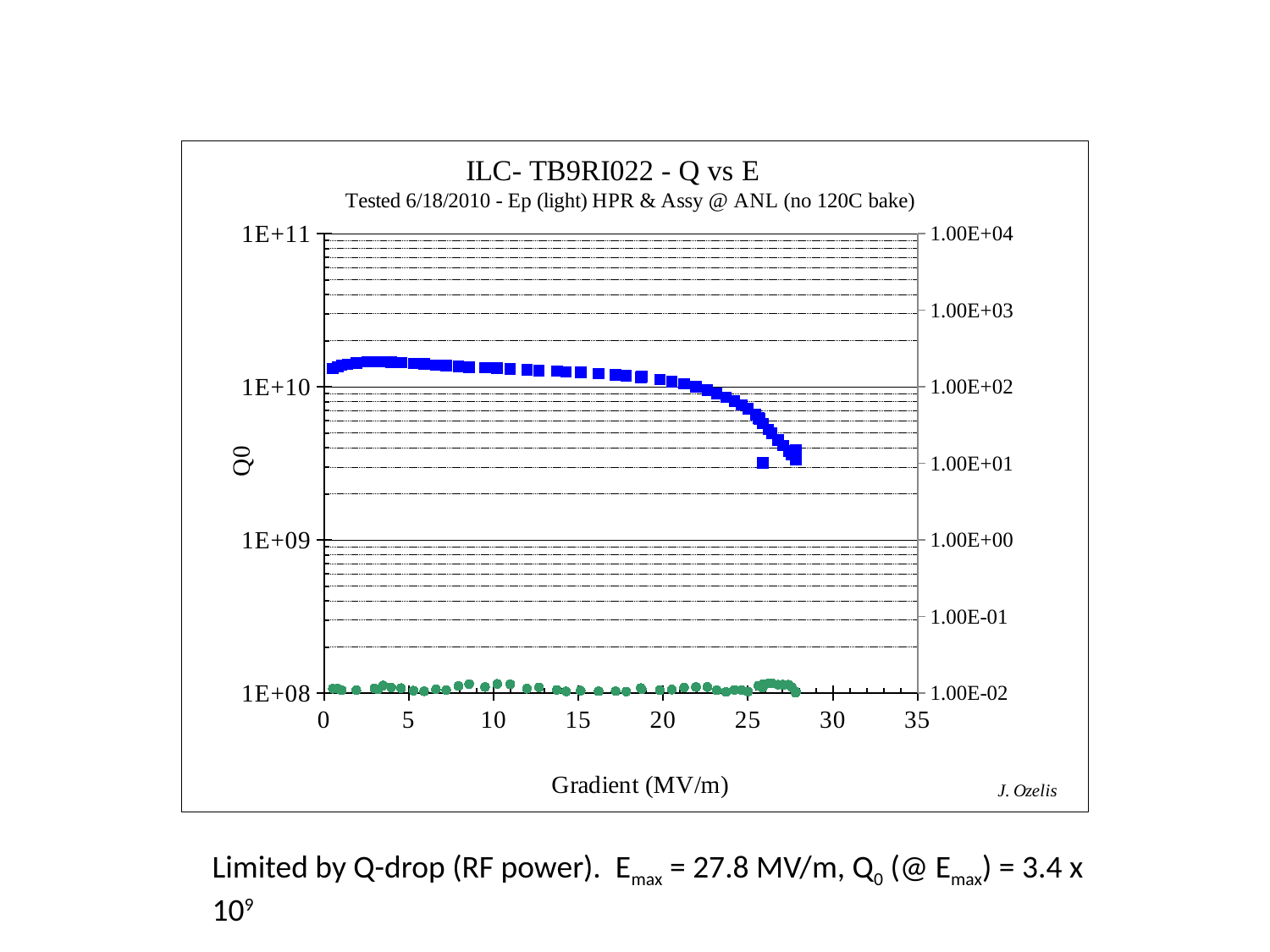
Is the Q0 value (blue squares) at a gradient of 5 MV/m greater or less than 1E+11? less What is the label of the x axis of the chart? Gradient (MV/m) According to the text below the chart, what is Emax? 27.8 MV/m What kind of chart is shown on the slide? scatter chart Is the Q0 value (blue squares) at a gradient of 27 MV/m greater or less than 1E+09? greater According to the text below the chart, what is Q0 at Emax? 3.4 x 10^9 How many data series (distinct marker colours) are plotted on the chart? 2 Is the Q0 value (blue squares) at a gradient of 10 MV/m greater or less than 1E+10? greater What is the title of the chart? ILC- TB9RI022 - Q vs E Does the Q0 series (blue squares) rise or fall as the gradient increases toward its maximum? fall What is the highest tick value shown on the x axis? 35